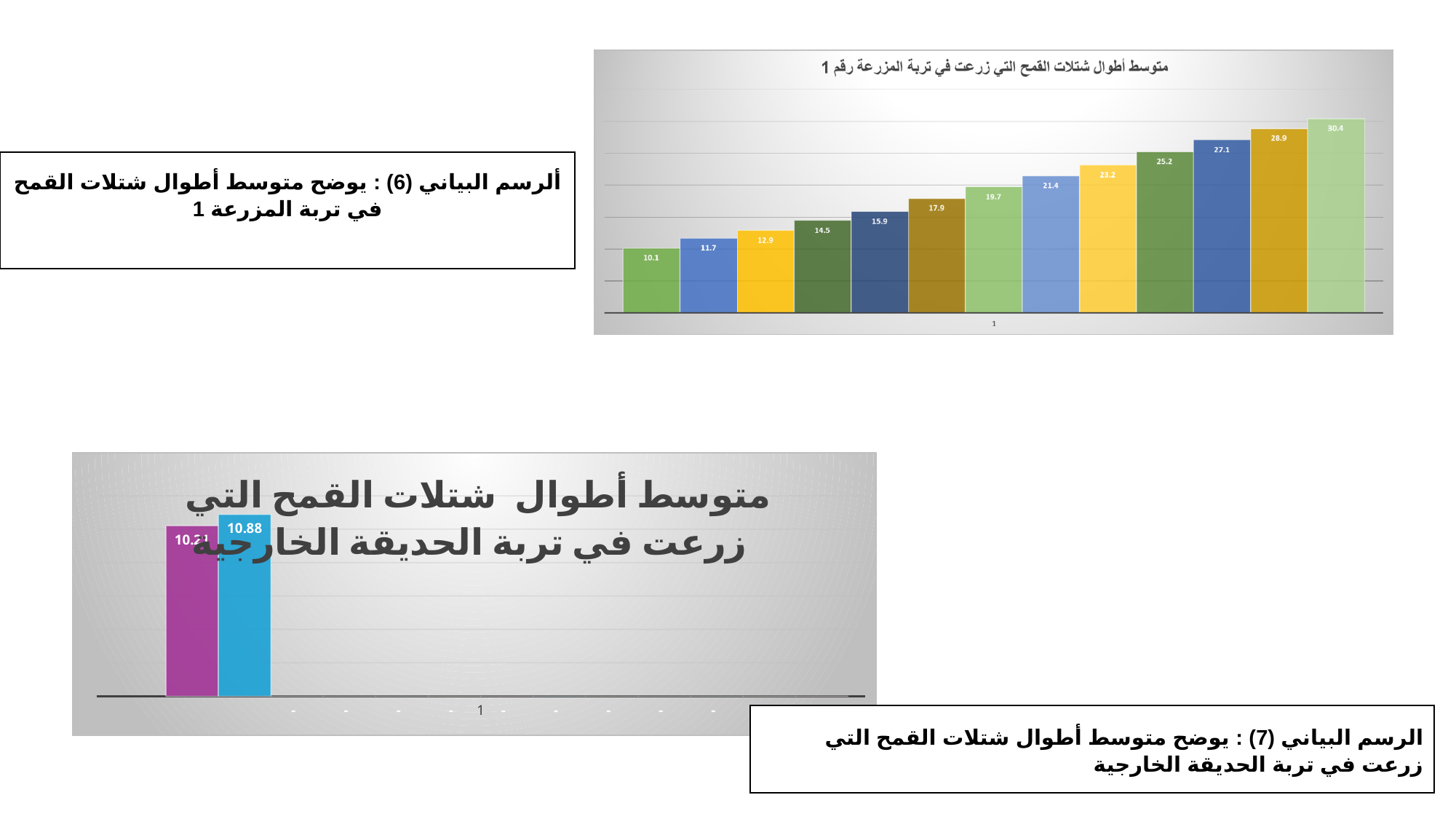
In the top chart (متوسط أطوال شتلات القمح التي زرعت في تربة المزرعة رقم 1), what kind of chart is shown? bar chart In the top chart, do the bar values rise or fall from left to right? rise In the top chart, what is the value of the rightmost bar? 30.4 In the top chart, what is the value of the leftmost bar? 10.1 In the top chart, what is the difference between the rightmost bar (30.4) and the leftmost bar (10.1)? 20.3 In the top chart, how many bars are plotted? 13 In the top chart, what is the difference between the bars labelled 23.2 and 21.4? 1.8 In the bottom chart, how many bars are plotted? 2 In the top chart, what is the lowest value shown? 10.1 In the bottom chart (متوسط أطوال شتلات القمح التي زرعت في تربة الحديقة الخارجية), what is the value of the blue bar? 10.88 In the top chart, what is the highest value shown? 30.4 In the top chart, what is the value of the fifth bar from the left (dark blue)? 15.9